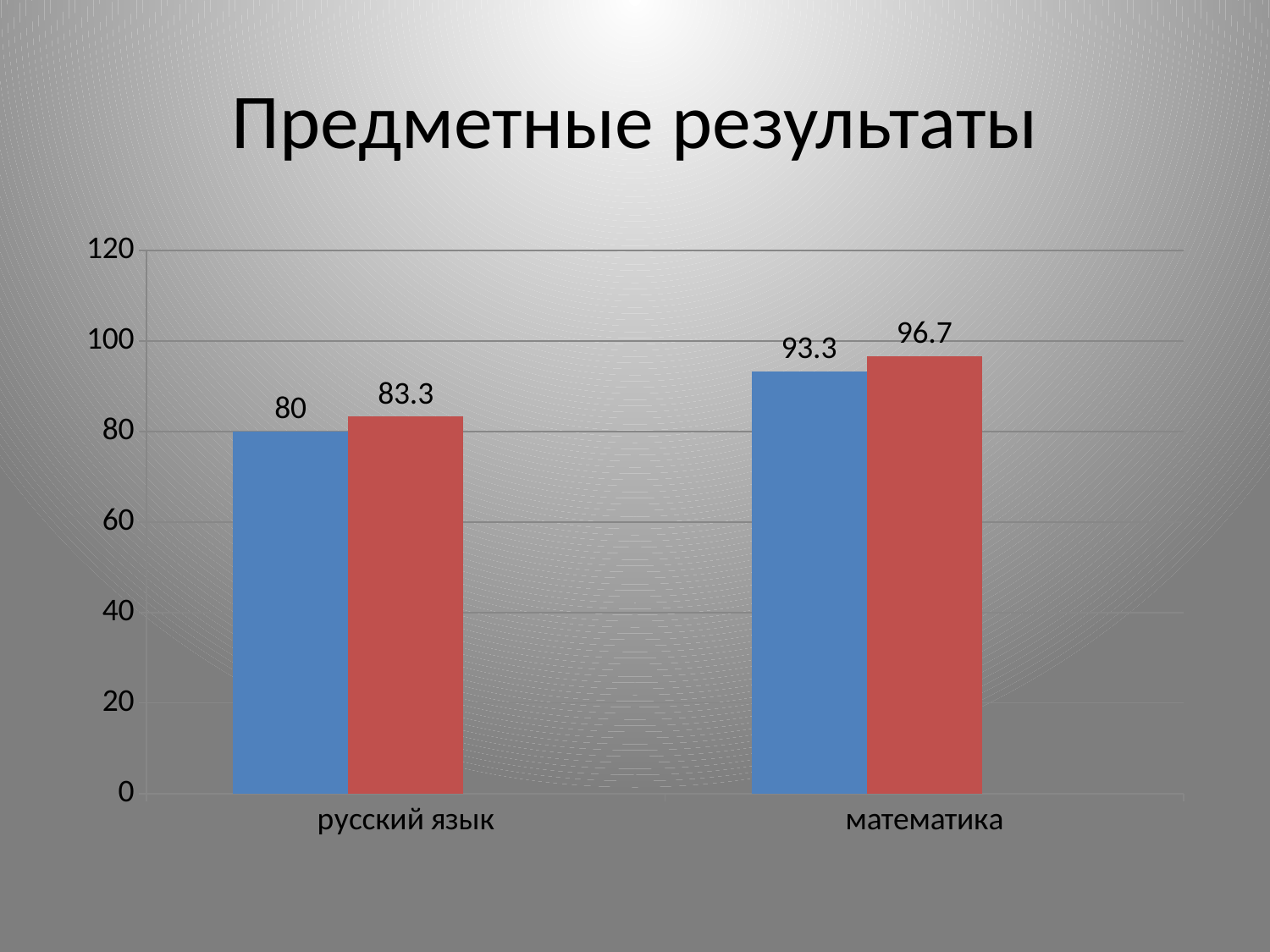
What is the difference between the red and blue bars for математика? 3.4 What is the value of the red bar for русский язык? 83.3 What is the value of the red bar for математика? 96.7 How many categories are shown on the x axis? 2 What is the value of the blue bar for русский язык? 80 What is the title of the slide? Предметные результаты Which is larger for русский язык, the blue bar or the red bar? the red bar What is the value of the blue bar for математика? 93.3 Is the blue bar for математика greater or less than 80? greater Which category has the highest red bar? математика Which category has the lowest blue bar? русский язык What kind of chart is shown on the slide? bar chart